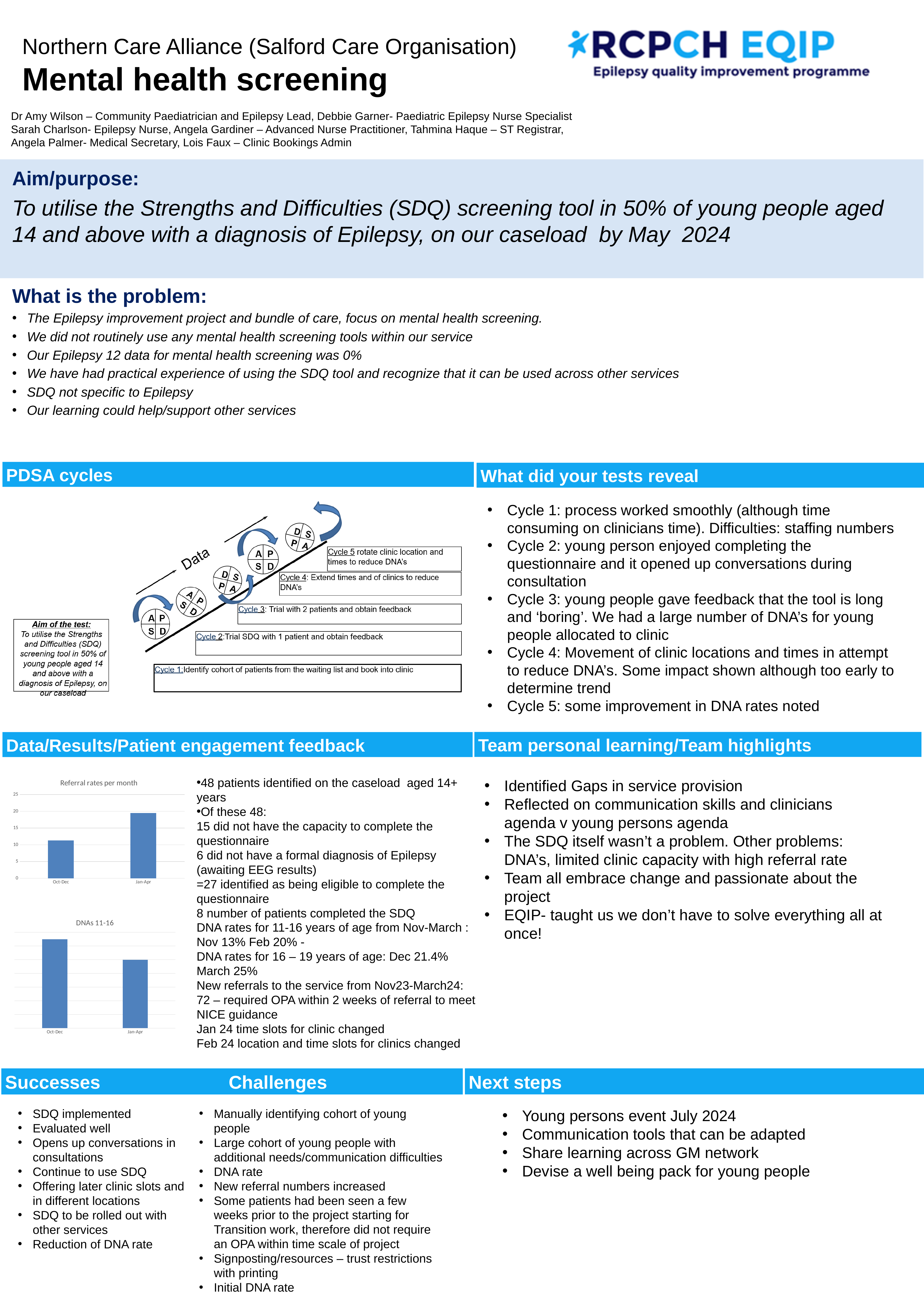
What kind of chart is the 'DNAs 11-16' chart? bar chart How many categories are shown on the x axis of the 'Referral rates per month' chart? 2 In the 'DNAs 11-16' chart, do the values rise or fall from Oct-Dec to Jan-Apr? fall What is the title of the upper chart in the Data/Results section? Referral rates per month In the 'Referral rates per month' chart, do the values rise or fall from Oct-Dec to Jan-Apr? rise In the 'Referral rates per month' chart, which category has the highest value? Jan-Apr In the 'DNAs 11-16' chart, which category has the higher value, Oct-Dec or Jan-Apr? Oct-Dec In the 'Referral rates per month' chart, is the value for Oct-Dec greater or less than 15? less What kind of chart is the 'Referral rates per month' chart? bar chart In the 'Referral rates per month' chart, which category has the lowest value? Oct-Dec How many categories are shown on the x axis of the 'DNAs 11-16' chart? 2 In the 'Referral rates per month' chart, is the value for Jan-Apr greater or less than 15? greater